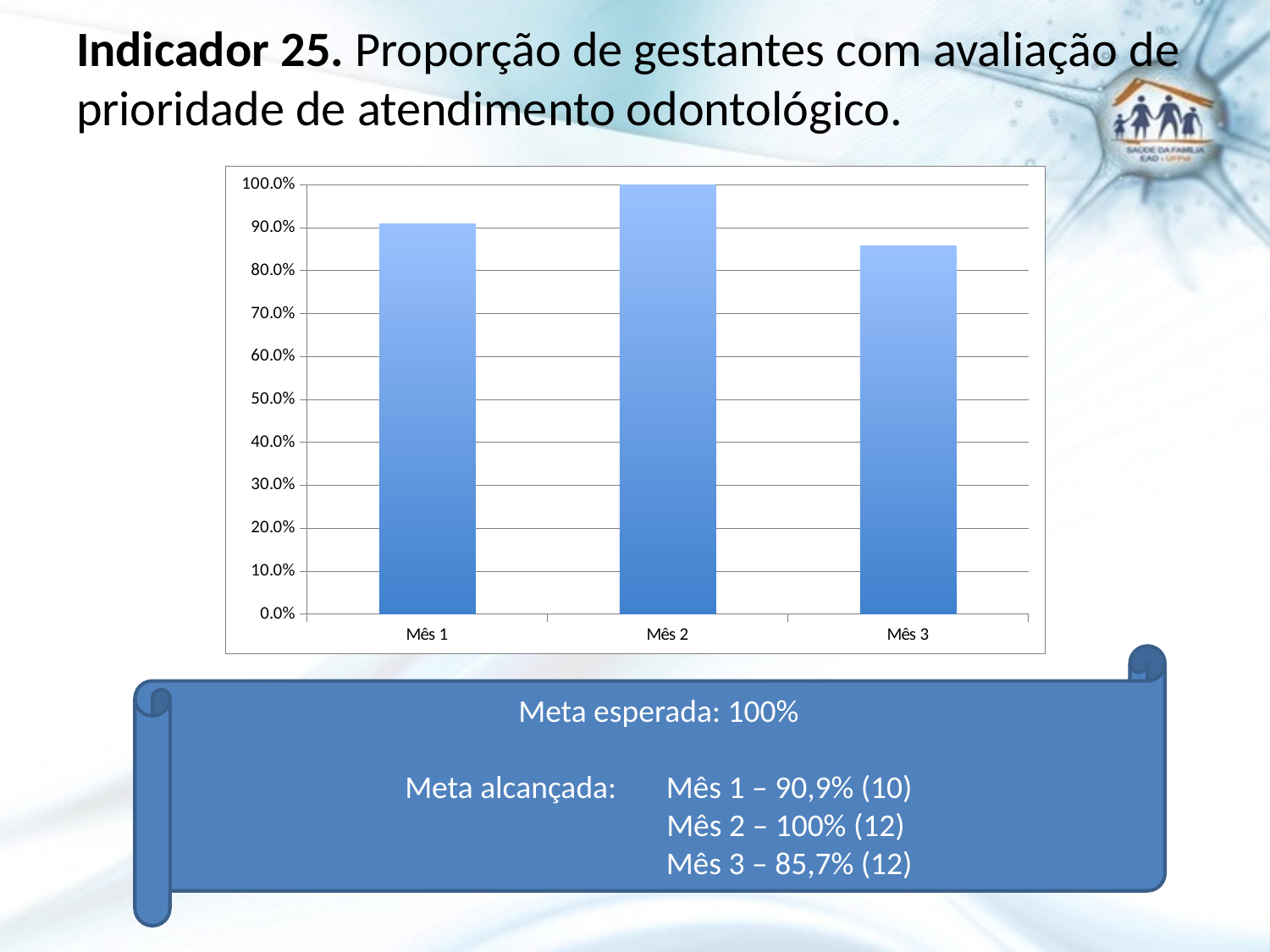
Which month has the lowest value in the chart? Mês 3 What kind of chart is shown on the slide? bar chart What is the expected target (meta esperada) stated on the slide? 100% What is the difference between the value for Mês 2 and the value for Mês 1? 9,1 percentage points What is the value for Mês 1? 90,9% Is the value for Mês 3 greater or less than 90.0%? less What is the value for Mês 2? 100% Is the value for Mês 1 greater or less than 90.0%? greater Which is larger, the value for Mês 1 or the value for Mês 3? Mês 1 What is the value for Mês 3? 85,7% How many categories (months) are plotted in the chart? 3 Which month has the highest value in the chart? Mês 2